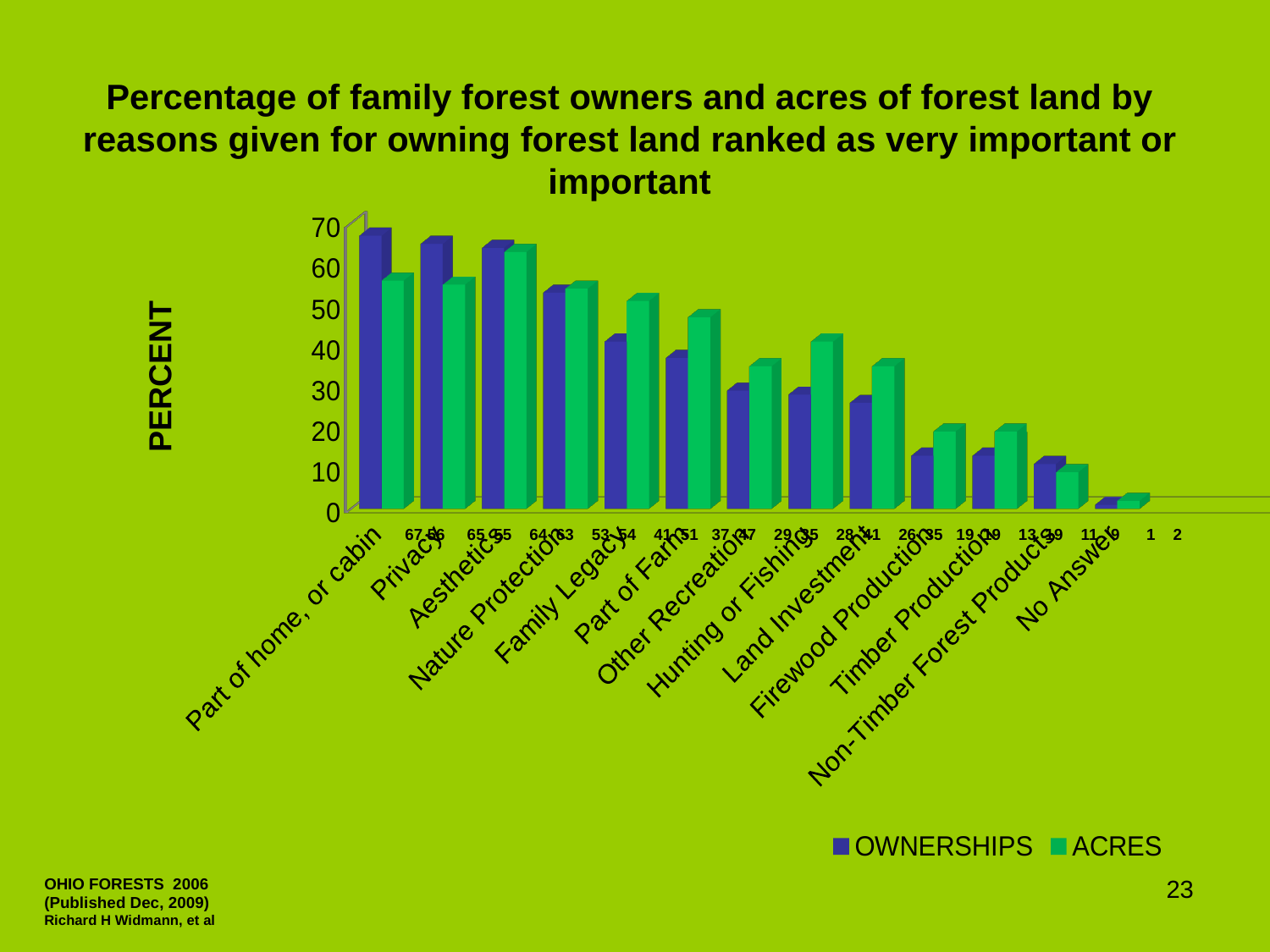
Do the OWNERSHIPS values generally rise or fall from left to right along the x axis? fall For Family Legacy, which is larger, OWNERSHIPS or ACRES? ACRES How many reason categories are shown on the x axis? 13 What is the OWNERSHIPS value for No Answer? 1 Which reason has the lowest OWNERSHIPS value? No Answer Which reason has the highest ACRES value? Aesthetics What kind of chart is shown on the slide? bar chart For Part of home, or cabin, which is larger, OWNERSHIPS or ACRES? OWNERSHIPS Is the OWNERSHIPS value for Timber Production greater or less than 20? less What is the ACRES value for No Answer? 2 How many series does the legend list? 2 Which reason has the highest OWNERSHIPS value? Part of home, or cabin